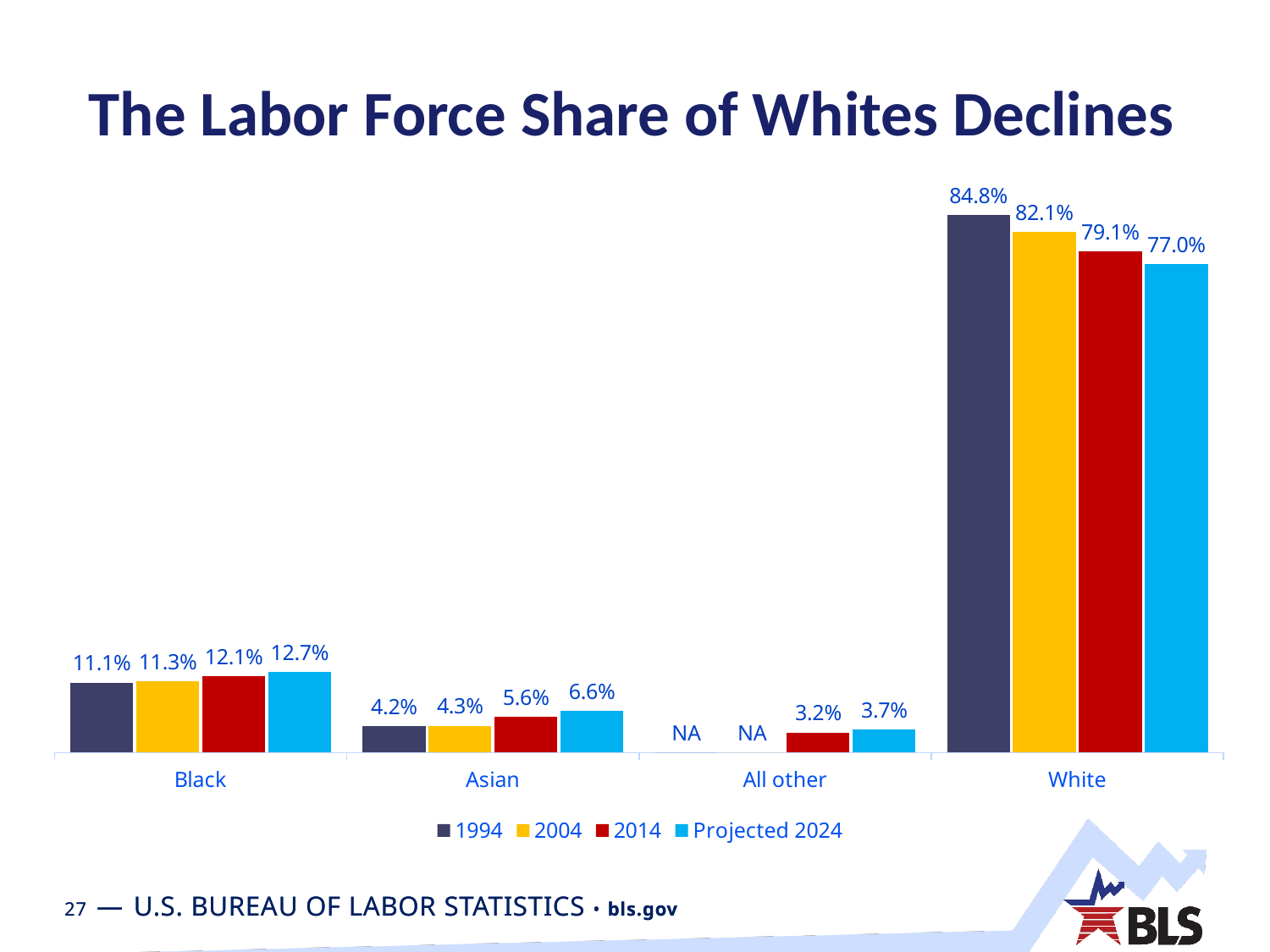
How many series does the legend list? 4 What is the labor force share of Asian in 2014? 5.6% What kind of chart is shown on the slide? Bar chart By how many percentage points does the White share fall from 1994 to projected 2024? 7.8 percentage points What is the projected 2024 labor force share for Black? 12.7% Which category has the lowest projected 2024 labor force share? All other Which category has the highest labor force share in 2014? White Do the White labor force share values rise or fall from 1994 to projected 2024? Fall How many categories are shown on the x axis? 4 What value is shown for All other in 2004? NA What is the labor force share of Whites in 1994? 84.8% Which is larger, the 2004 share for Black or the 2004 share for Asian? Black